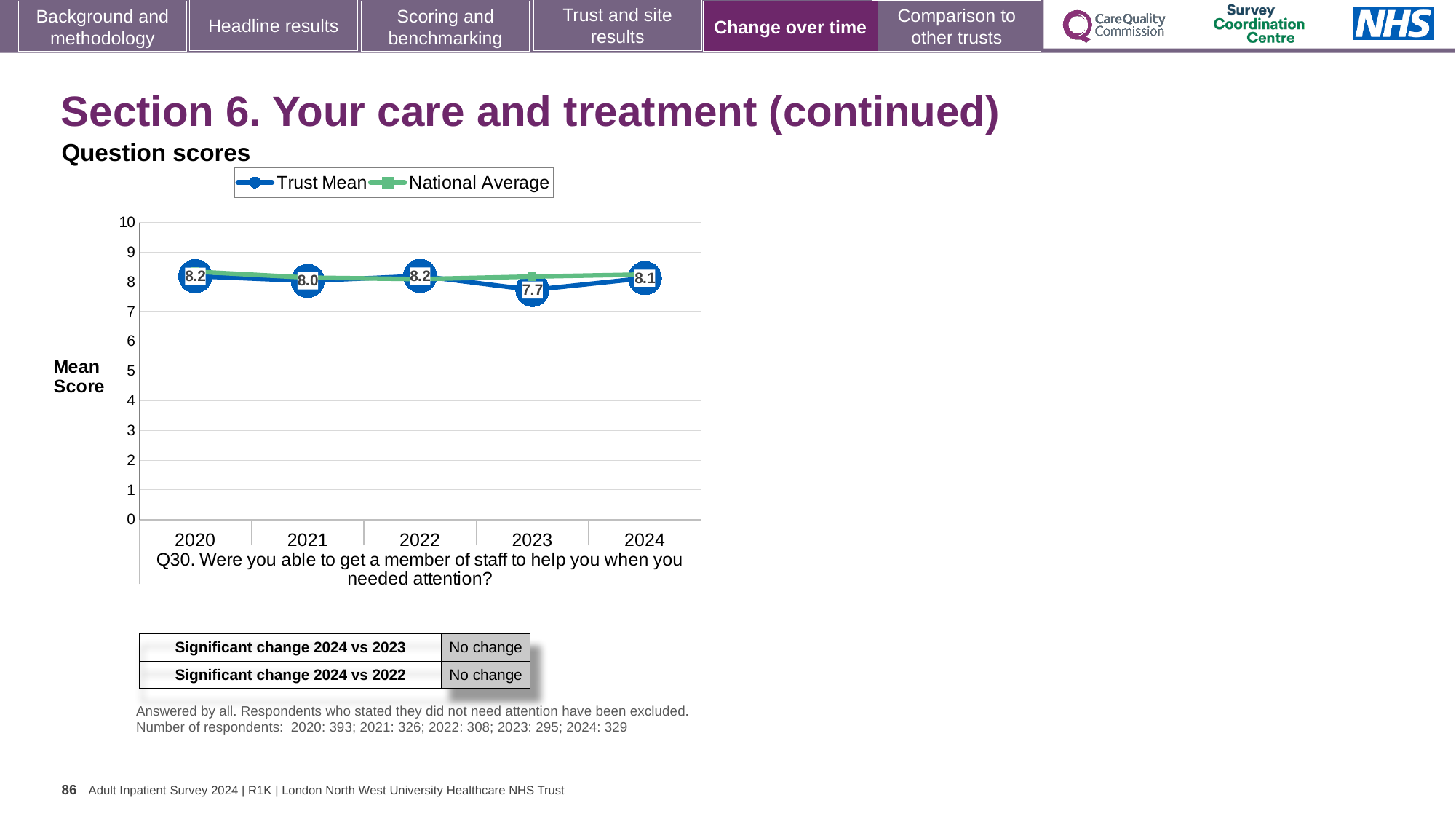
How many years are shown on the x axis of the chart? 5 What is the Trust Mean score for 2023? 7.7 What is the Trust Mean score for 2024? 8.1 In which year is the Trust Mean score lowest? 2023 What is the difference between the Trust Mean scores for 2022 and 2023? 0.5 What kind of chart is shown on the slide? Line chart Does the Trust Mean score rise or fall from 2022 to 2023? Fall What is the label on the y axis of the chart? Mean Score What is the Trust Mean score for 2020? 8.2 Is the National Average value for 2020 greater or less than 7? greater Which year has the higher Trust Mean score, 2021 or 2024? 2024 How many series does the legend list? 2